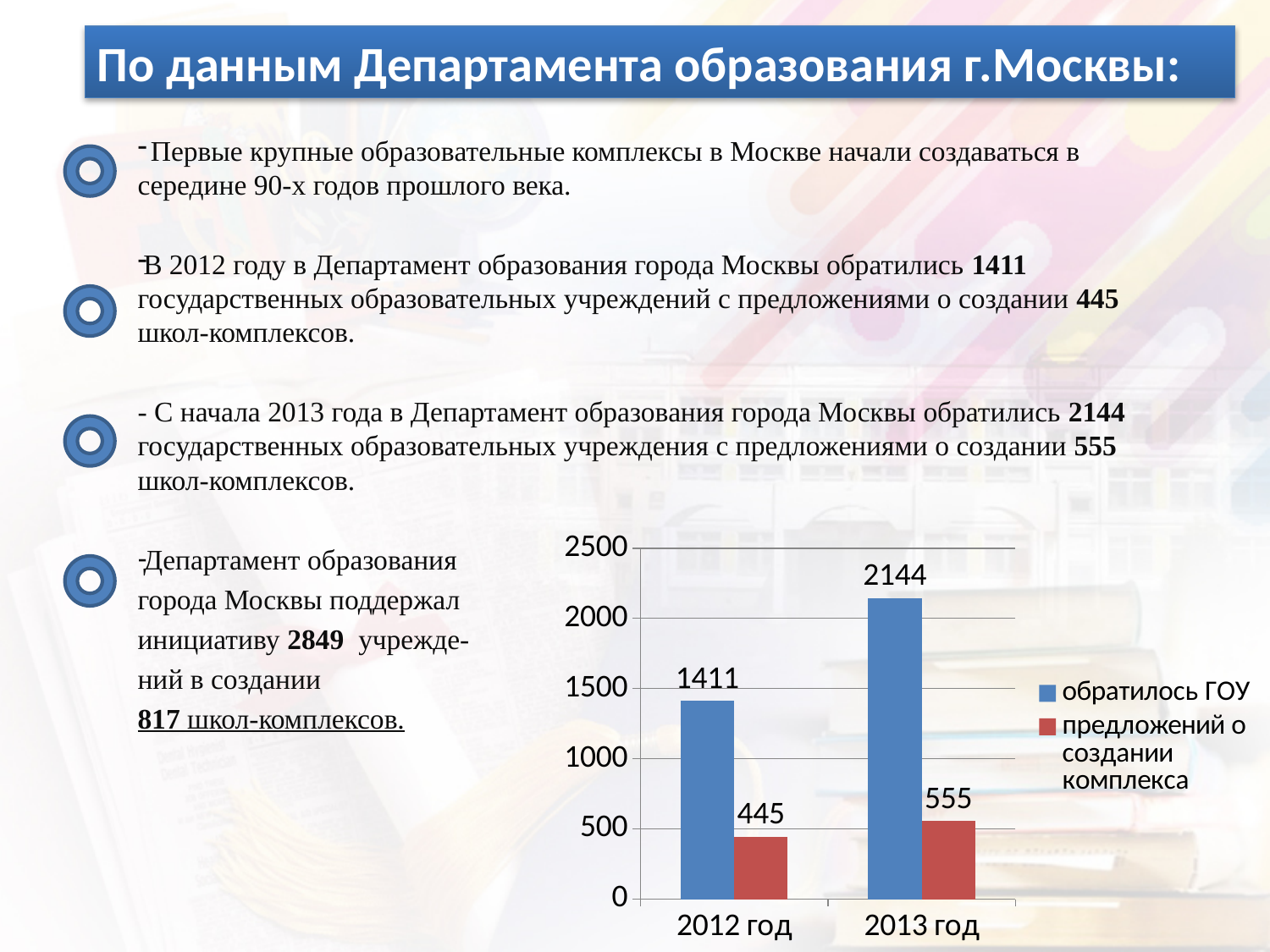
What is the difference between the 'предложений о создании комплекса' values for 2013 год and 2012 год? 110 What is the difference between the 'обратилось ГОУ' values for 2013 год and 2012 год? 733 How many categories are shown on the x axis of the chart? 2 What is the value for 'обратилось ГОУ' in 2012 год? 1411 Which year has the lower value for 'предложений о создании комплекса'? 2012 год What is the value for 'предложений о создании комплекса' in 2013 год? 555 What is the value for 'обратилось ГОУ' in 2013 год? 2144 What kind of chart is shown on the slide? bar chart What is the value for 'предложений о создании комплекса' in 2012 год? 445 How many series does the chart legend list? 2 Is the value for 'обратилось ГОУ' in 2013 год greater or less than 2000? greater Which year has the higher value for 'обратилось ГОУ'? 2013 год